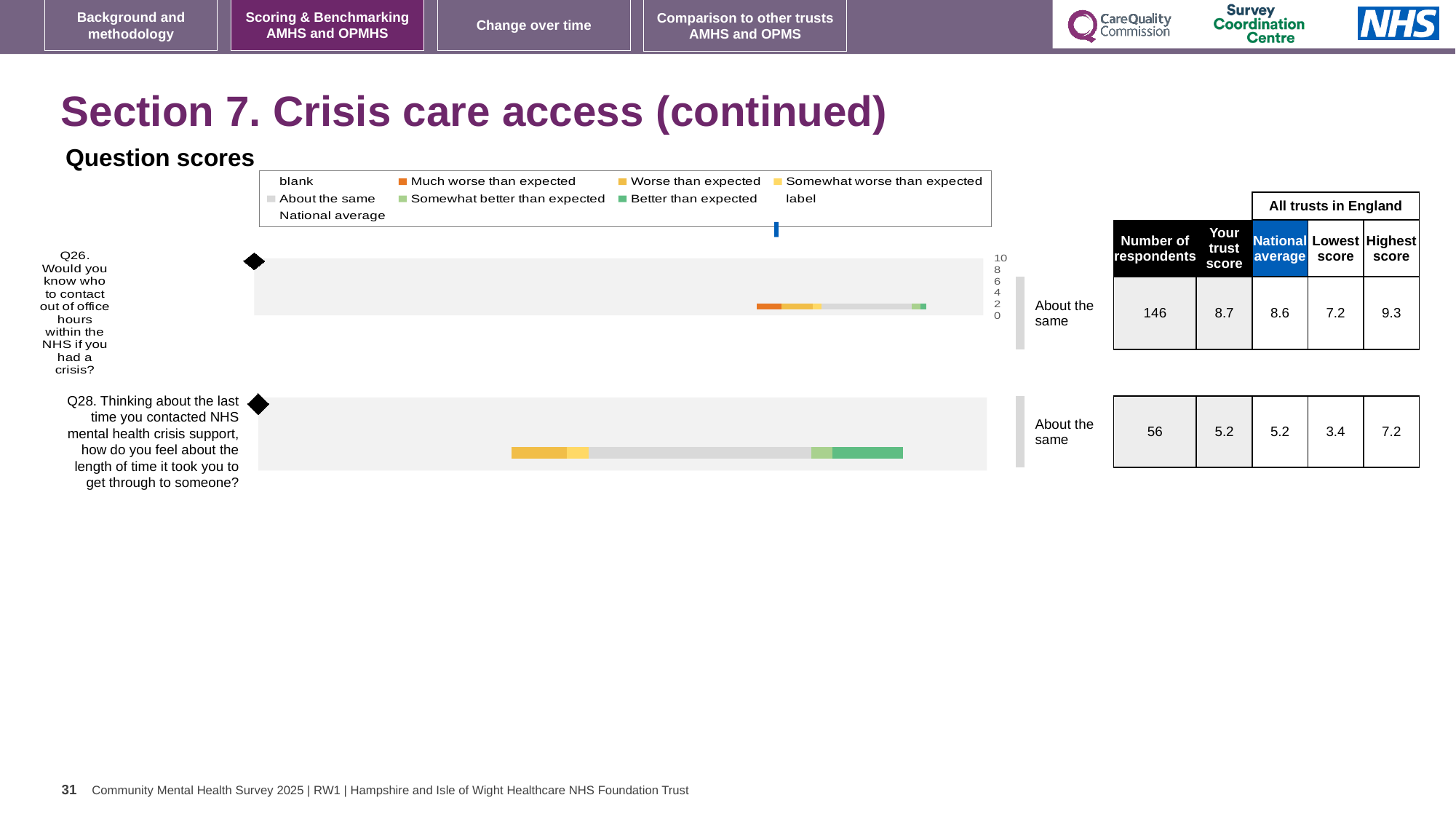
How many respondents answered Q28 (Thinking about the last time you contacted NHS mental health crisis support, how do you feel about the length of time it took you to get through to someone?)? 56 What is the 'Your trust score' value for Q26 (Would you know who to contact out of office hours within the NHS if you had a crisis?)? 8.7 How many more respondents answered Q26 than Q28? 90 What is the difference between the highest score and the lowest score for Q28? 3.8 What benchmark category label is shown next to the bar for Q28? About the same What is the national average score for Q26? 8.6 What kind of chart is used to show the question scores for Q26 and Q28? Bar chart What is the difference between the highest score and the lowest score for Q26? 2.1 What colour does the legend use for 'Much worse than expected'? Orange Which question has the higher 'Your trust score', Q26 or Q28? Q26 How many questions are plotted in the question scores chart? 2 What is the highest score among all trusts in England for Q28? 7.2